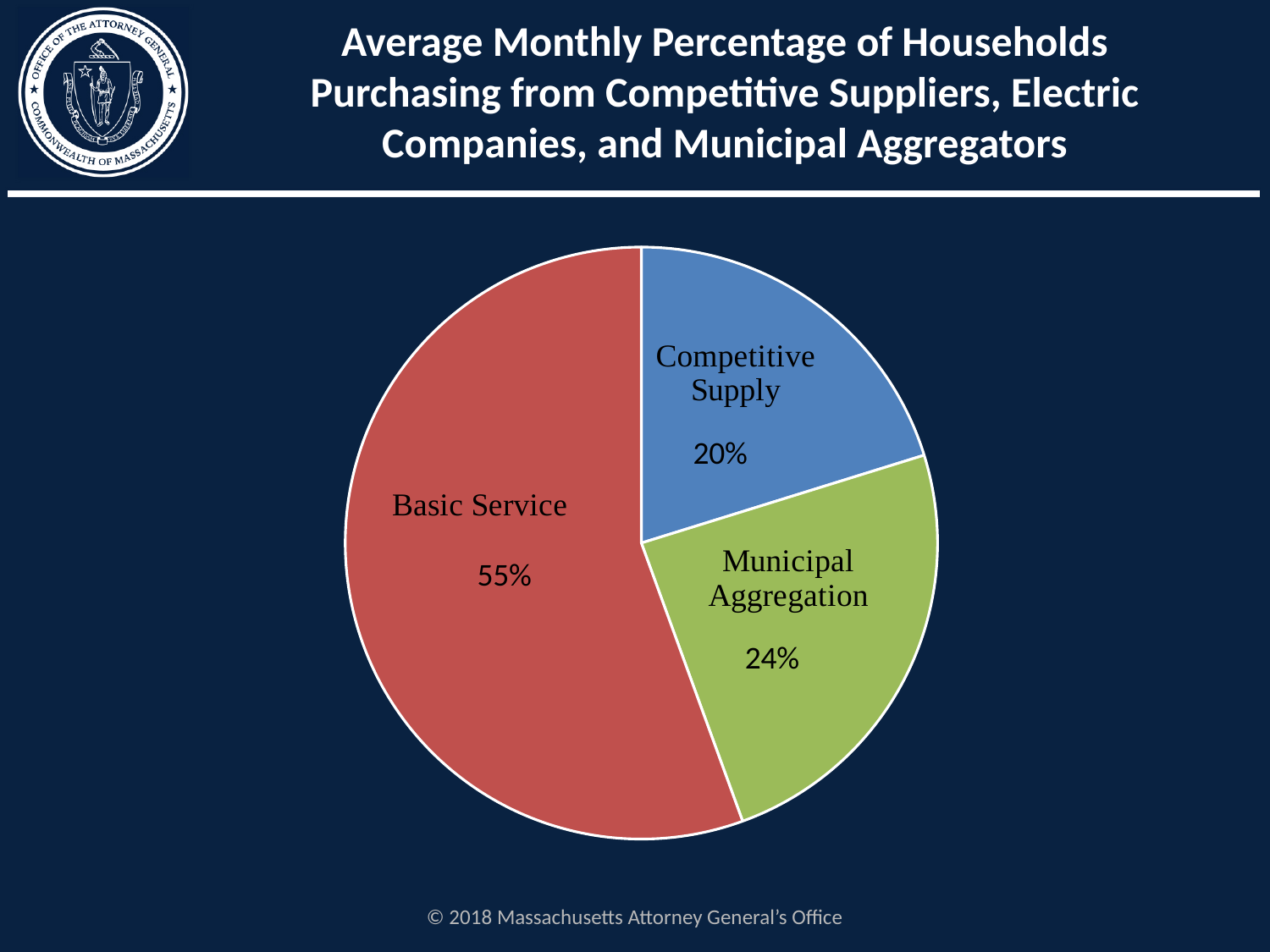
Which slice of the pie is the smallest? Competitive Supply What colour is the Basic Service slice? red What is the difference in percentage points between Basic Service and Municipal Aggregation? 31 What percentage of households is shown for Municipal Aggregation? 24% What is the difference in percentage points between Municipal Aggregation and Competitive Supply? 4 What is the title of the slide containing the pie chart? Average Monthly Percentage of Households Purchasing from Competitive Suppliers, Electric Companies, and Municipal Aggregators How many slices does the pie chart have? 3 What percentage of households is shown for Basic Service? 55% Which slice of the pie is the largest? Basic Service What kind of chart is shown on the slide? pie chart What percentage of households is shown for Competitive Supply? 20% Which is larger, the share for Municipal Aggregation or the share for Competitive Supply? Municipal Aggregation